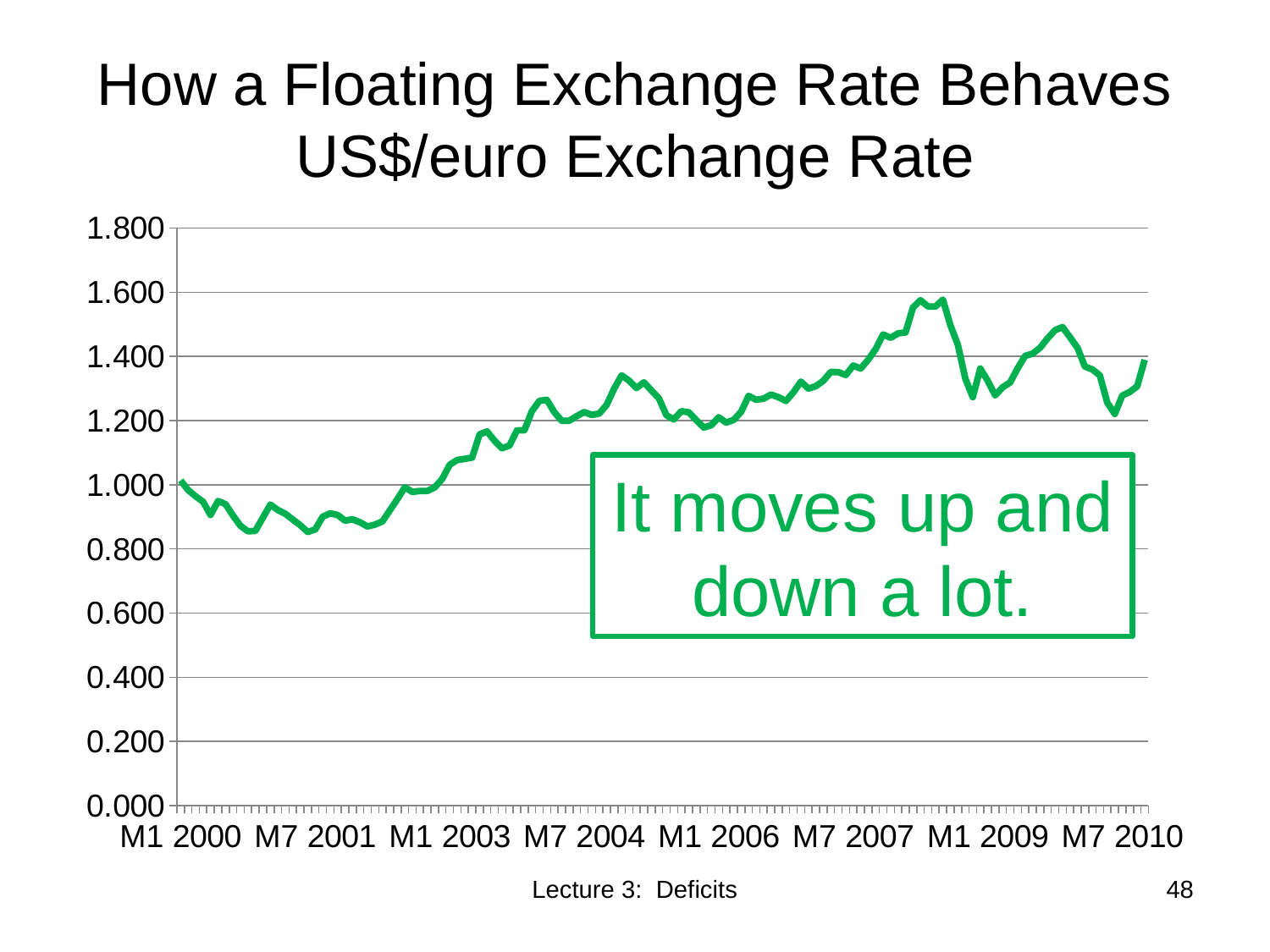
What is the highest value shown on the y axis? 1.800 Is the value for M1 2006 greater or less than 1.400? less What kind of chart is shown on the slide? line chart Is the value for M7 2001 greater or less than 1.000? less Is the value for M7 2010 greater or less than 1.000? greater What does the green text box on the chart say? It moves up and down a lot. Overall, does the exchange rate rise or fall from M1 2000 to M7 2010? rise How many labels are shown on the x axis? 8 Which is larger, the value for M7 2001 or the value for M7 2007? M7 2007